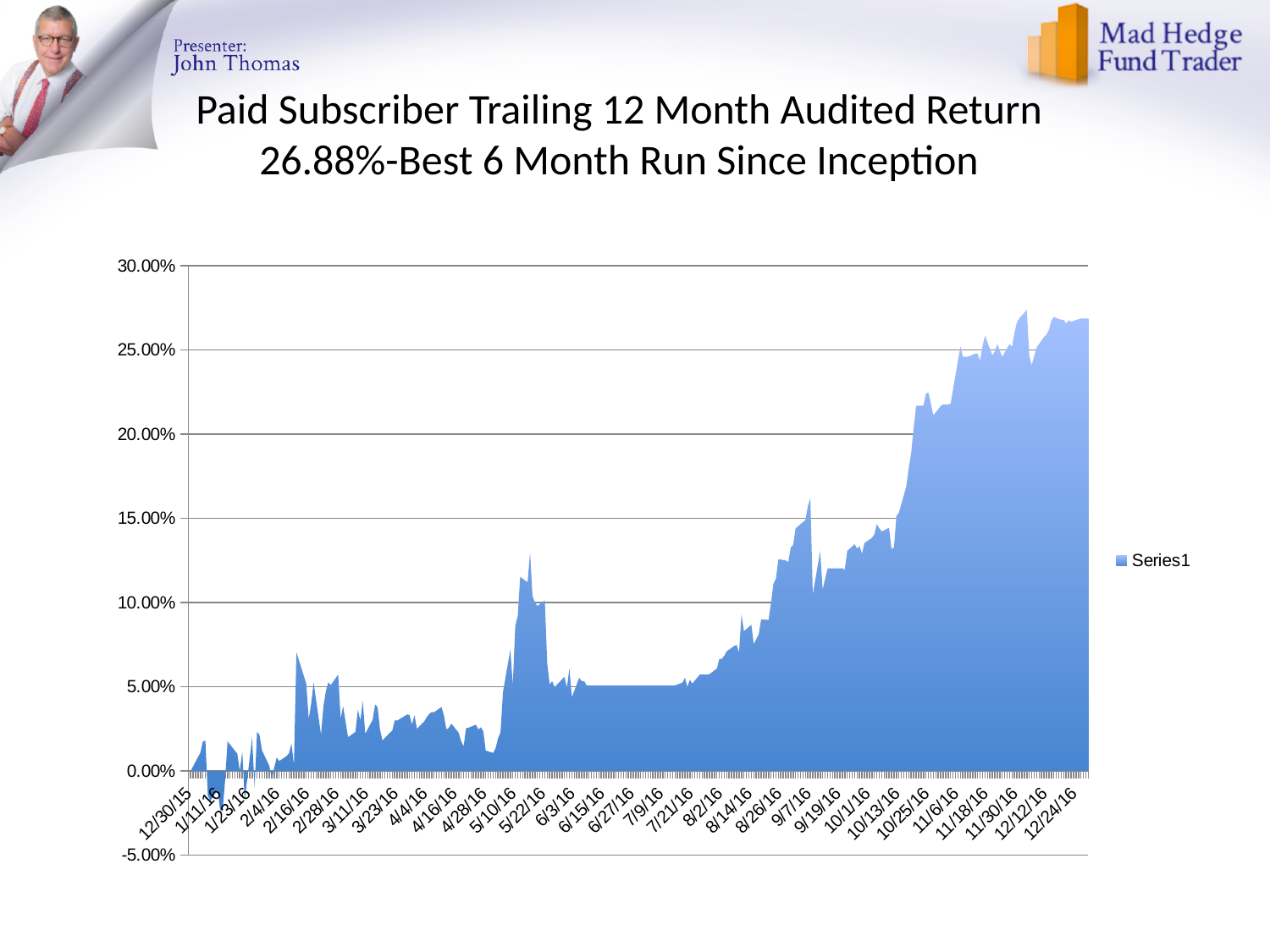
Is the value for 12/24/16 greater or less than 25.00%? greater Overall, do the values rise or fall from 12/30/15 to 12/24/16? Rise Is the value for 11/6/16 greater or less than 20.00%? greater What kind of chart is shown on the slide? Area chart Is the value for 6/15/16 greater or less than 10.00%? less What is the name of the series shown in the legend? Series1 What is the highest value shown on the vertical axis? 30.00% Which date has the larger value, 12/30/15 or 12/24/16? 12/24/16 Which date has the larger value, 5/22/16 or 6/27/16? 5/22/16 How many series does the legend list? 1